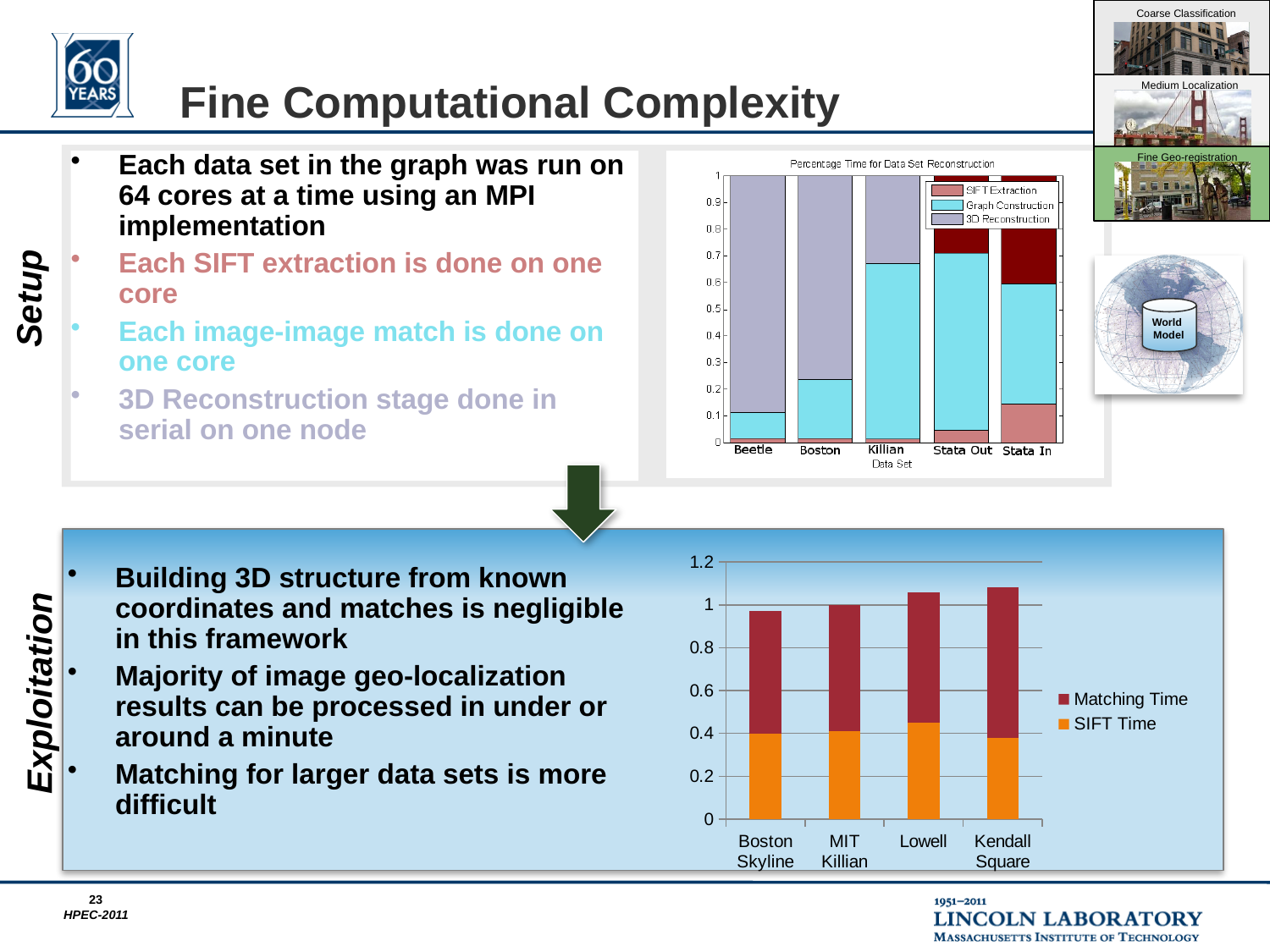
In the bottom-right chart, is the total stacked value for Boston Skyline greater or less than 1? less What is the title of the top-right chart? Percentage Time for Data Set Reconstruction In the bottom-right chart, is the total stacked value for Lowell greater or less than 1? greater How many data sets are shown on the x axis of the bottom-right chart? 4 How many data sets are shown on the x axis of the top-right chart 'Percentage Time for Data Set Reconstruction'? 5 In the top-right chart 'Percentage Time for Data Set Reconstruction', is the 3D Reconstruction share for Beetle greater or less than 0.8? greater In the bottom-right chart, which series is shown in orange? SIFT Time How many series does the legend of the top-right chart 'Percentage Time for Data Set Reconstruction' list? 3 What kind of chart is the bottom-right chart with the Matching Time and SIFT Time legend? stacked bar chart In the bottom-right chart, which data set has the largest SIFT Time segment? Lowell How many series does the legend of the bottom-right chart list? 2